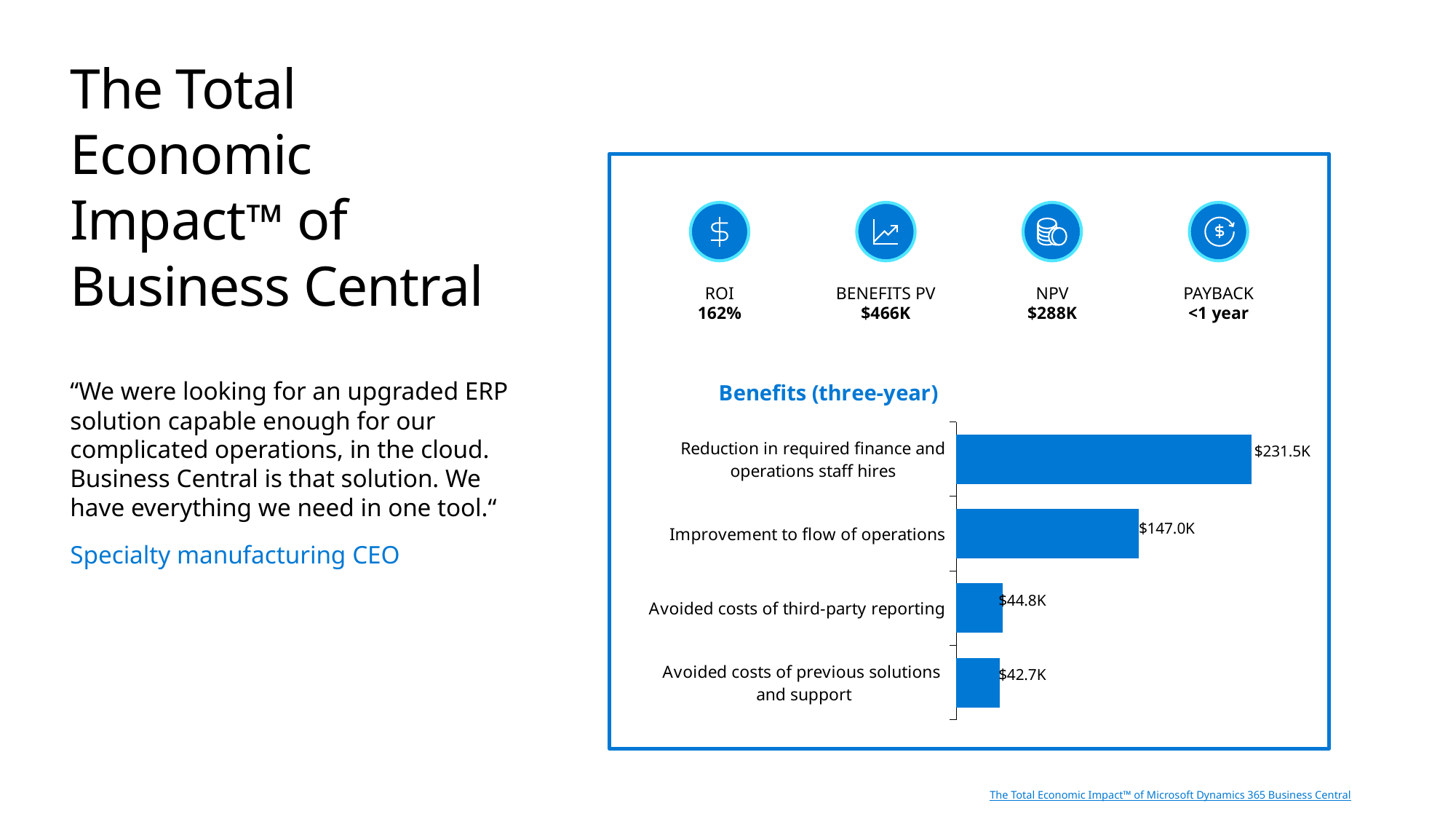
What is the difference between the values for Avoided costs of third-party reporting and Avoided costs of previous solutions and support in the Benefits (three-year) chart? $2.1K What is the difference between the values for Reduction in required finance and operations staff hires and Improvement to flow of operations in the Benefits (three-year) chart? $84.5K What is the value for Reduction in required finance and operations staff hires in the Benefits (three-year) chart? $231.5K What kind of chart is the Benefits (three-year) chart? Bar chart What is the value for Improvement to flow of operations in the Benefits (three-year) chart? $147.0K What is the title of the chart on the slide? Benefits (three-year) In the Benefits (three-year) chart, which is larger: Improvement to flow of operations or Avoided costs of third-party reporting? Improvement to flow of operations Which category has the lowest value in the Benefits (three-year) chart? Avoided costs of previous solutions and support What is the value for Avoided costs of previous solutions and support in the Benefits (three-year) chart? $42.7K What is the value for Avoided costs of third-party reporting in the Benefits (three-year) chart? $44.8K Which category has the highest value in the Benefits (three-year) chart? Reduction in required finance and operations staff hires How many categories are shown in the Benefits (three-year) chart? 4